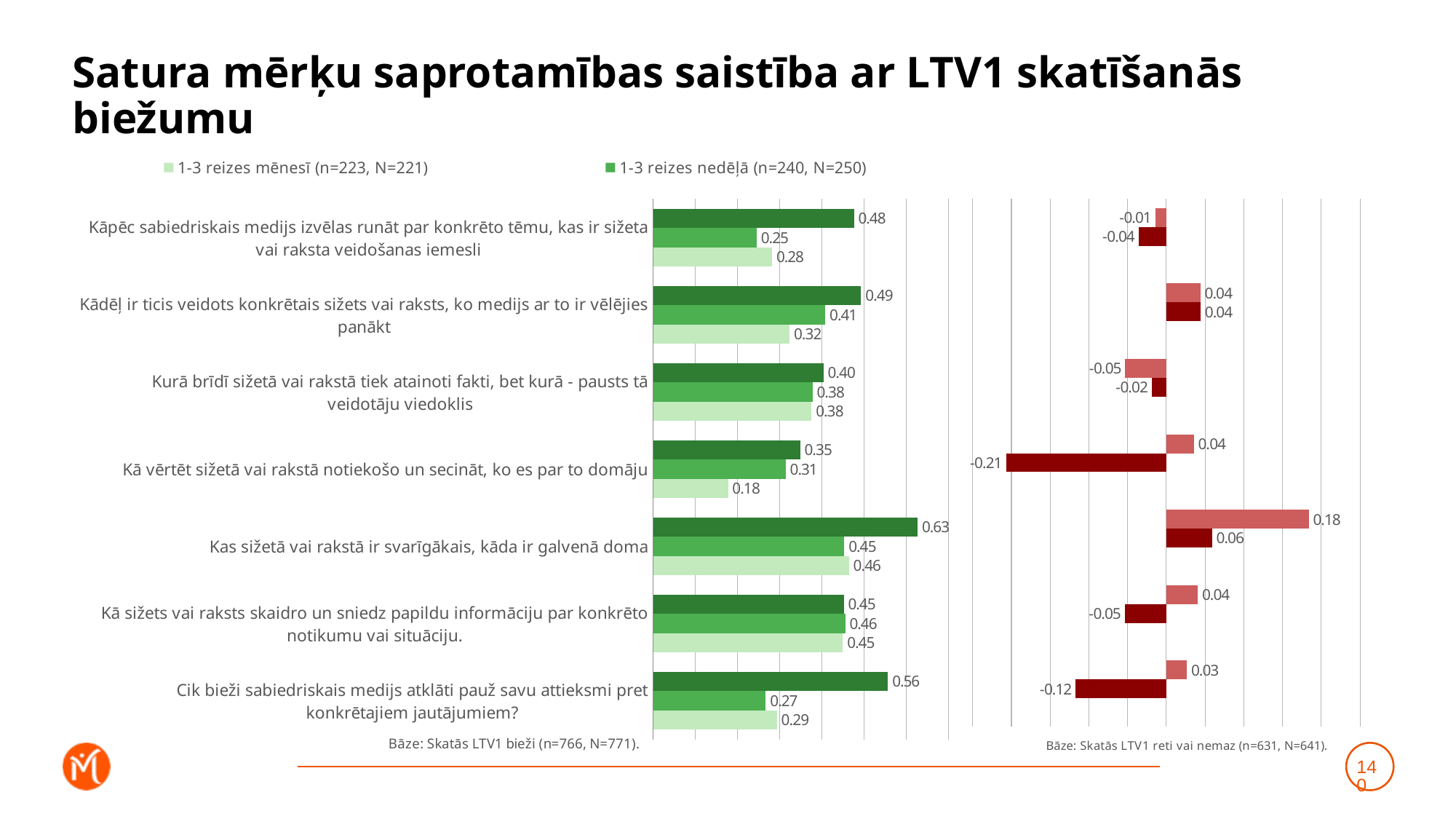
In the left chart, which category has the lowest value for the "1-3 reizes mēnesī" series? Kā vērtēt sižetā vai rakstā notiekošo un secināt, ko es par to domāju In the left chart, which category has the highest dark green bar value? Kas sižetā vai rakstā ir svarīgākais, kāda ir galvenā doma In the right chart, which category has the lowest dark red bar value? Kā vērtēt sižetā vai rakstā notiekošo un secināt, ko es par to domāju In the left chart, what is the difference between the dark green bar (0.56) and the "1-3 reizes nedēļā" bar (0.27) for "Cik bieži sabiedriskais medijs atklāti pauž savu attieksmi pret konkrētajiem jautājumiem?"? 0.29 In the right chart, what is the value of the light red bar for "Kas sižetā vai rakstā ir svarīgākais, kāda ir galvenā doma"? 0.18 In the left chart, for "Kāpēc sabiedriskais medijs izvēlas runāt par konkrēto tēmu...", which is larger: the "1-3 reizes mēnesī" value or the "1-3 reizes nedēļā" value? 1-3 reizes mēnesī In the left chart, what is the value for the "1-3 reizes mēnesī" series for "Kā vērtēt sižetā vai rakstā notiekošo un secināt, ko es par to domāju"? 0.18 How many categories are shown in the left chart? 7 In the right chart, what is the value of the dark red bar for "Kā vērtēt sižetā vai rakstā notiekošo un secināt, ko es par to domāju"? -0.21 In the left chart, what is the value of the dark green bar for "Kas sižetā vai rakstā ir svarīgākais, kāda ir galvenā doma"? 0.63 What type of chart is the left chart? Bar chart In the left chart, what is the value for the "1-3 reizes nedēļā" series for "Kādēļ ir ticis veidots konkrētais sižets vai raksts, ko medijs ar to ir vēlējies panākt"? 0.41